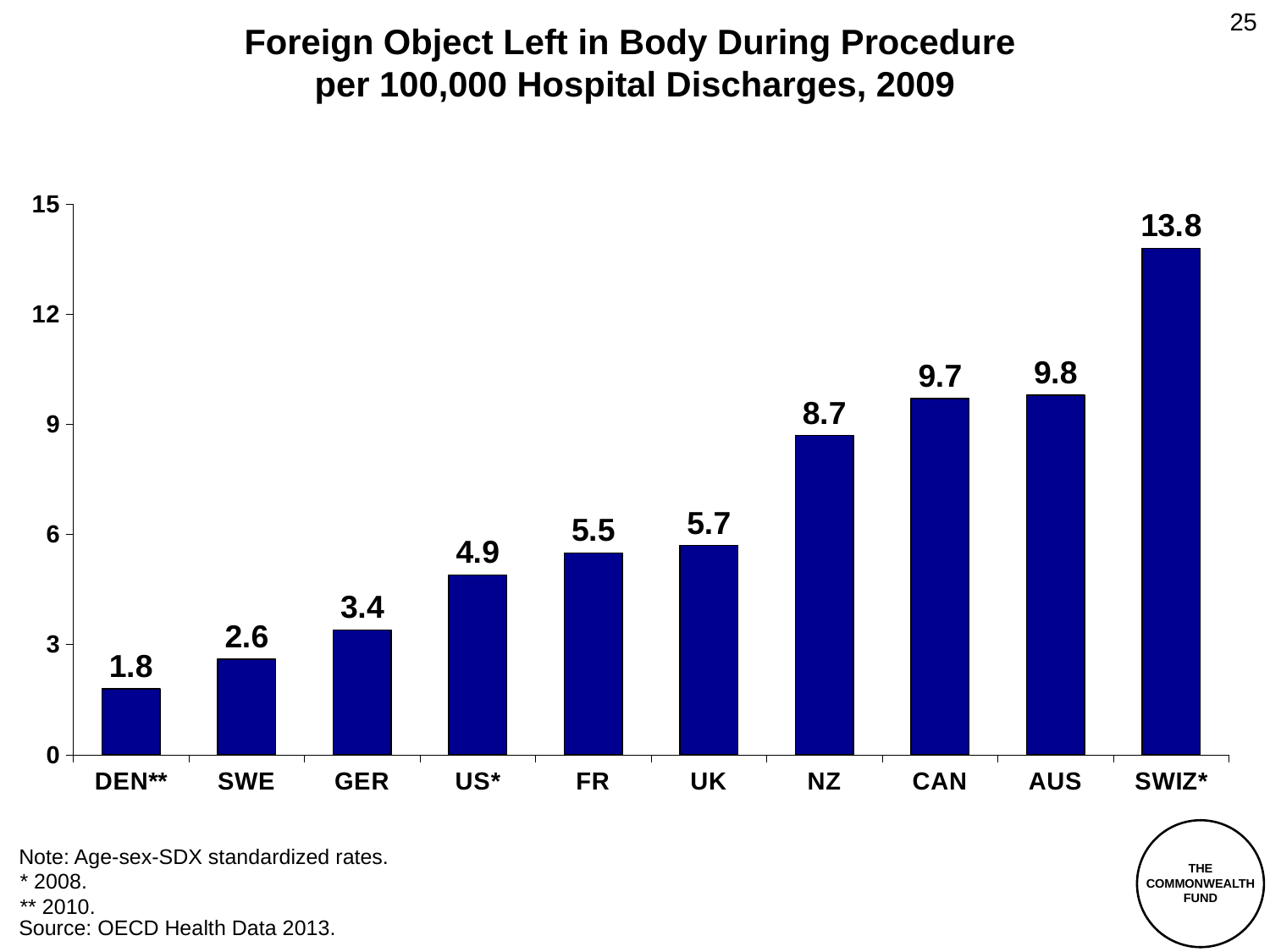
What is the value for US* in the chart? 4.9 Which has a higher value, GER or UK? UK What is the difference between the values for UK and FR? 0.2 How many countries are shown in the chart? 10 What is the value for NZ? 8.7 What is the source cited for the chart data? OECD Health Data 2013 Which country has the lowest rate? DEN** What kind of chart is shown on the slide? Bar chart What is the difference between the values for SWIZ* and DEN**? 12.0 Which country has the highest rate of foreign objects left in body? SWIZ* Is the value for CAN greater or less than 9? greater Do the values rise or fall from left to right across the countries? Rise